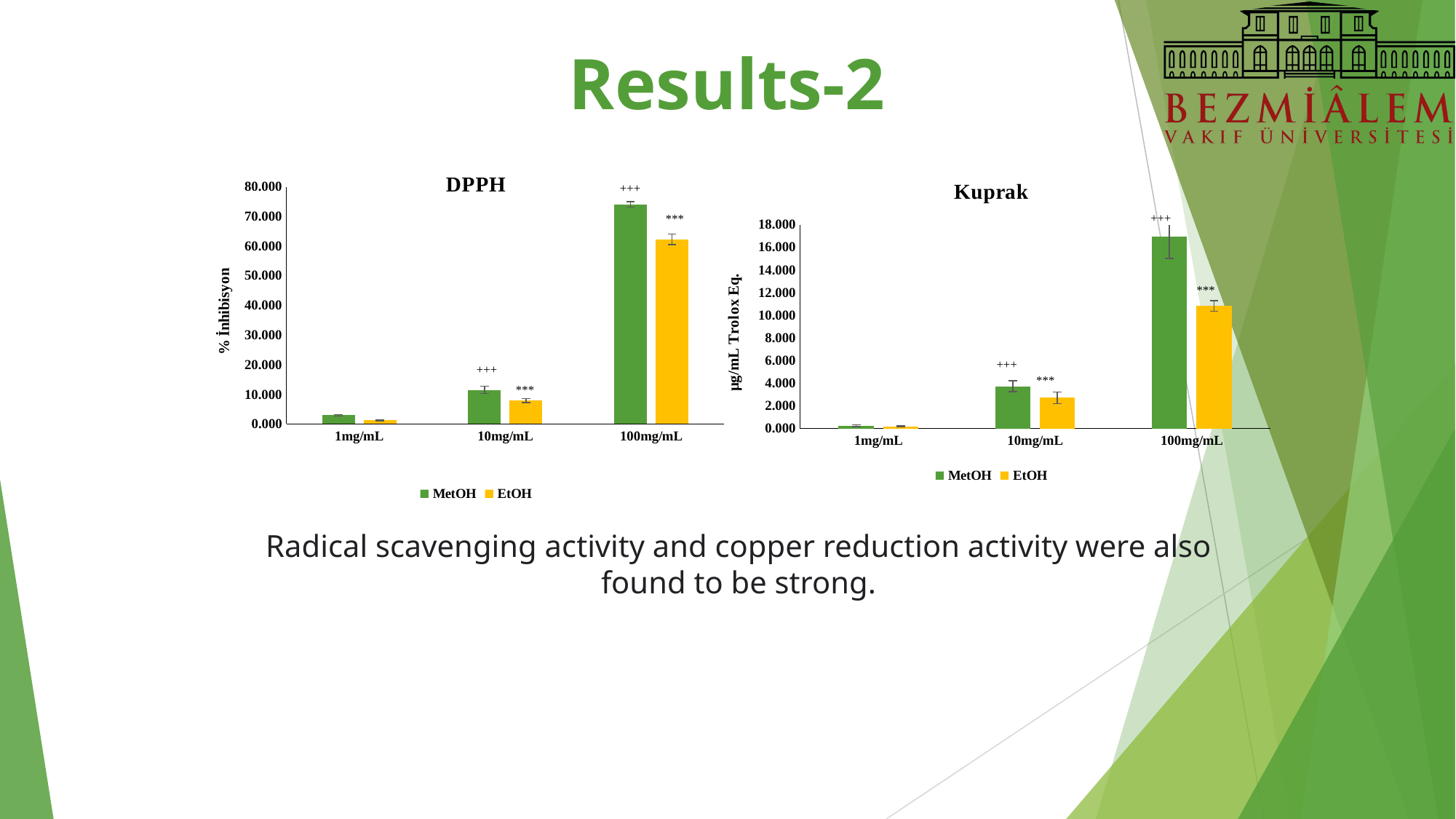
How many concentration categories are shown on the x axis of the DPPH chart? 3 What kind of chart is the DPPH chart? bar chart In the DPPH chart, is the EtOH value at 100mg/mL greater or less than 70.000? less What is the y-axis label of the Kuprak chart? µg/mL Trolox Eq. In the Kuprak chart, which concentration has the lowest EtOH value? 1mg/mL In the Kuprak chart, do the MetOH values rise or fall as concentration increases along the x axis? rise In the DPPH chart, which is larger at 100mg/mL, MetOH or EtOH? MetOH In the Kuprak chart, is the MetOH value at 100mg/mL greater or less than 14.000? greater In the Kuprak chart, is the EtOH value at 100mg/mL greater or less than 8.000? greater How many series does the legend of the Kuprak chart list? 2 In the DPPH chart, which concentration has the highest MetOH value? 100mg/mL